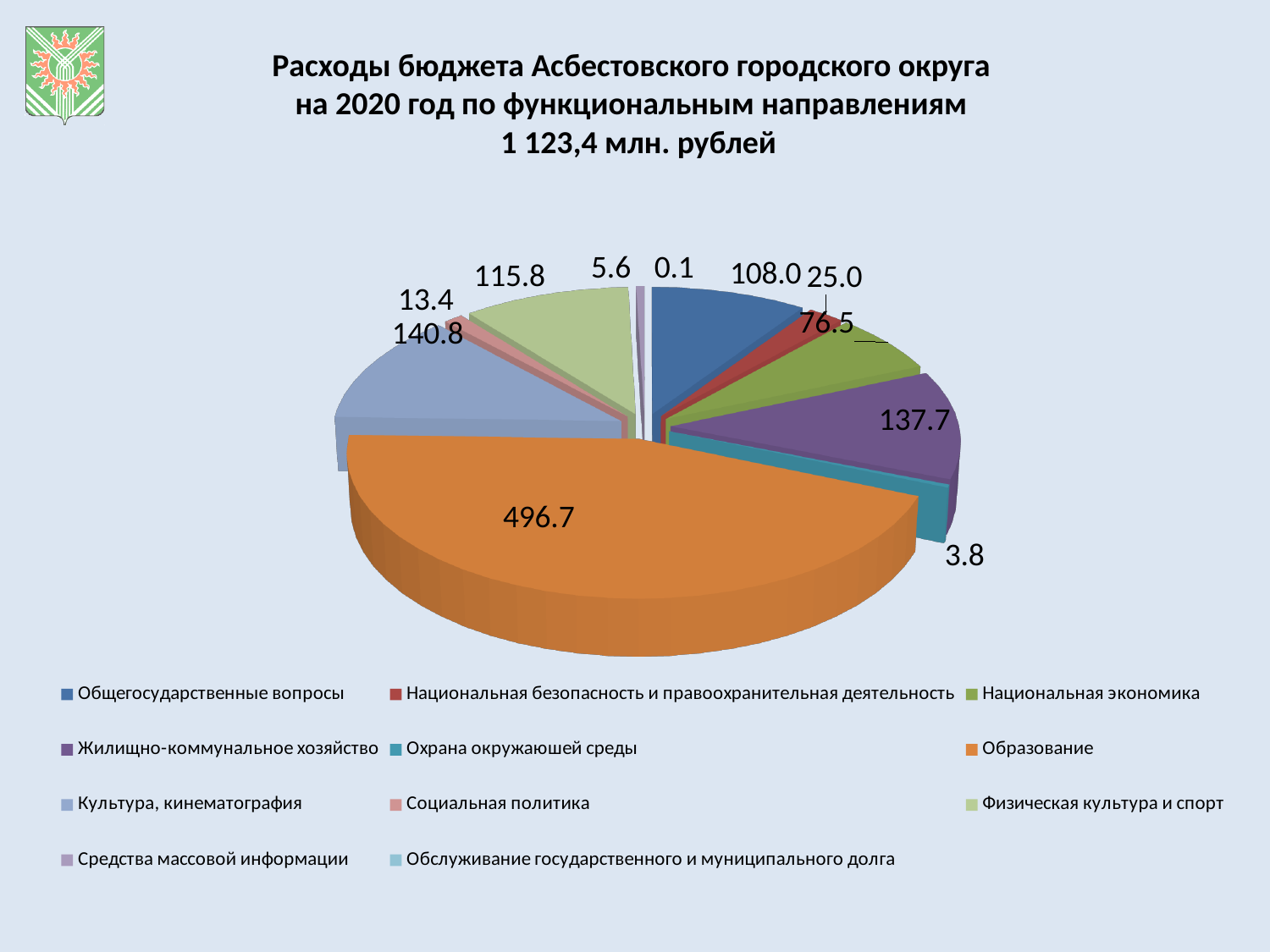
What kind of chart is shown on the slide? Pie chart Which is larger: the value for Общегосударственные вопросы or the value for Национальная экономика? Общегосударственные вопросы What is the difference between the values for Культура, кинематография and Жилищно-коммунальное хозяйство? 3.1 Which category has the largest slice of the pie? Образование What is the value for Общегосударственные вопросы? 108.0 What is the value for Образование on the pie chart? 496.7 What is the value for Охрана окружающей среды? 3.8 What is the value for Культура, кинематография? 140.8 What is the value for Жилищно-коммунальное хозяйство? 137.7 What is the total amount of budget expenditure stated in the chart title? 1 123,4 млн. рублей Which category has the smallest value on the chart? Обслуживание государственного и муниципального долга How many categories does the legend list? 11